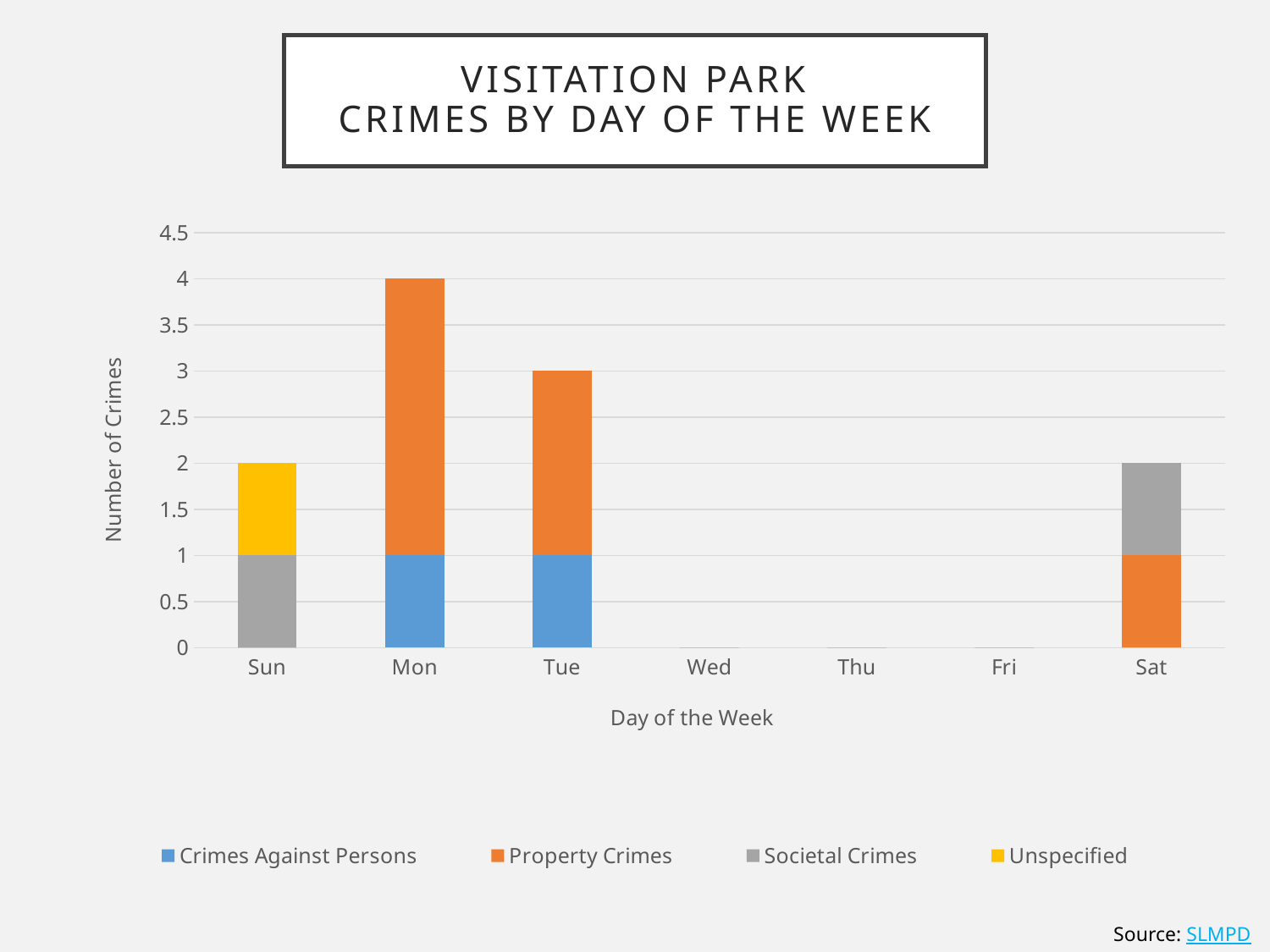
How many Unspecified crimes are shown for Sun? 1 Which day has the highest total number of crimes? Mon What is the total number of crimes on Mon? 4 What is the title of the chart? Visitation Park Crimes by Day of the Week How many Property Crimes are shown for Mon? 3 What is the total number of crimes on Sat? 2 How many days of the week are shown on the x axis? 7 What kind of chart is shown on the slide? Stacked bar chart How many series does the legend list? 4 Which is larger, the total crimes on Tue or the total crimes on Sat? Tue What is the total number of crimes on Tue? 3 What is the difference between the total crimes on Mon and the total crimes on Tue? 1